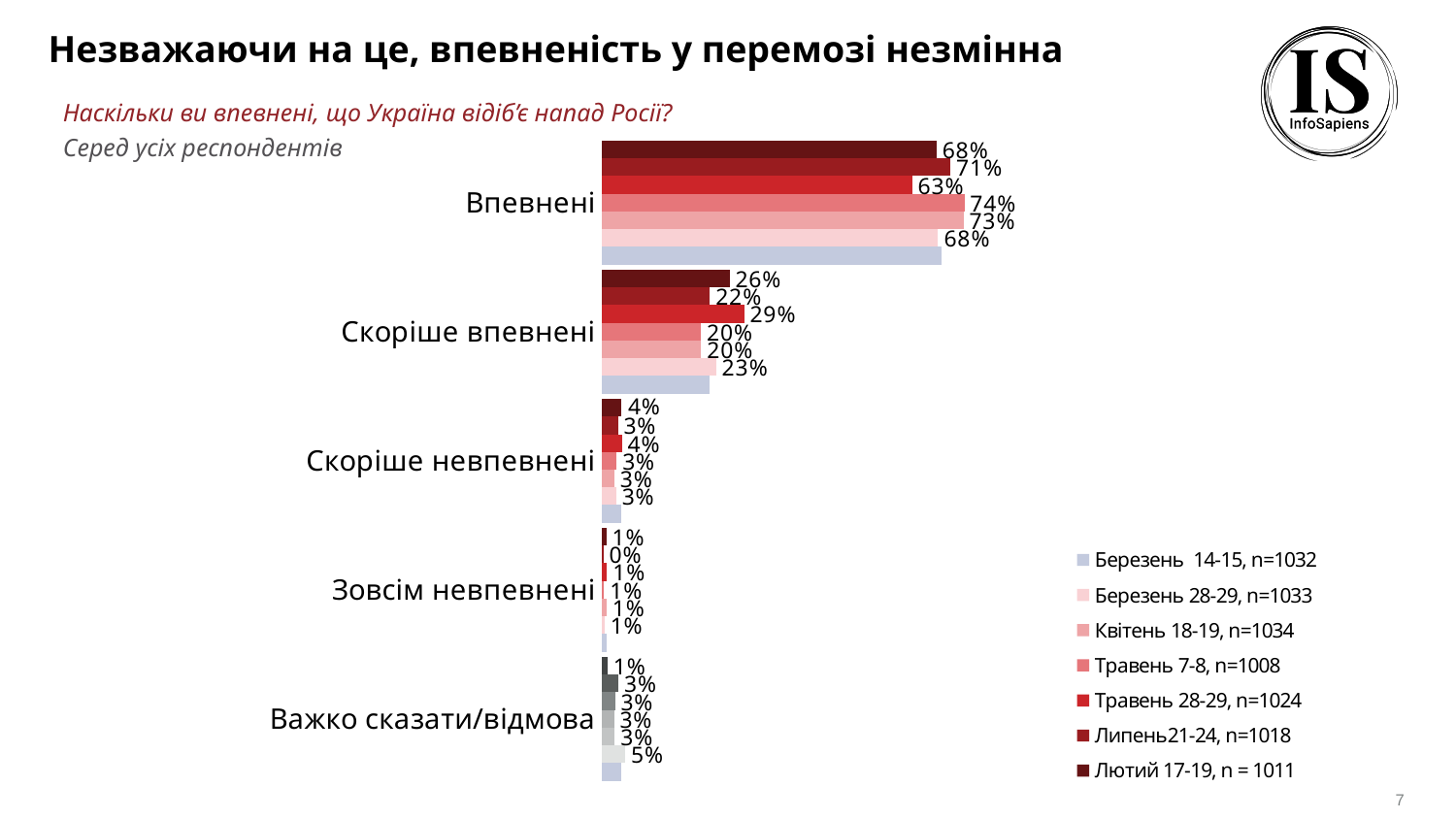
What type of chart is shown on the slide? Bar chart In which survey wave was the share of 'Впевнені' respondents the highest? Травень 7-8 (74%) How many response categories are shown on the chart? 5 What is the value for 'Зовсім невпевнені' in the Липень 21-24 wave? 0% What is the value for 'Скоріше впевнені' in the Травень 28-29 wave? 29% What percentage of respondents were 'Впевнені' in the Травень 7-8 survey wave? 74% What is the value for 'Важко сказати/відмова' in the Березень 28-29 wave? 5% In which survey wave was the share of 'Впевнені' respondents the lowest? Травень 28-29 (63%) What is the difference in percentage points between the 'Впевнені' values for Травень 7-8 and Травень 28-29? 11 percentage points For 'Скоріше впевнені', which is larger: the value for Лютий 17-19 or for Липень 21-24? Лютий 17-19 How many survey waves does the legend list? 7 What is the sample size (n) for the Лютий 17-19 wave according to the legend? 1011